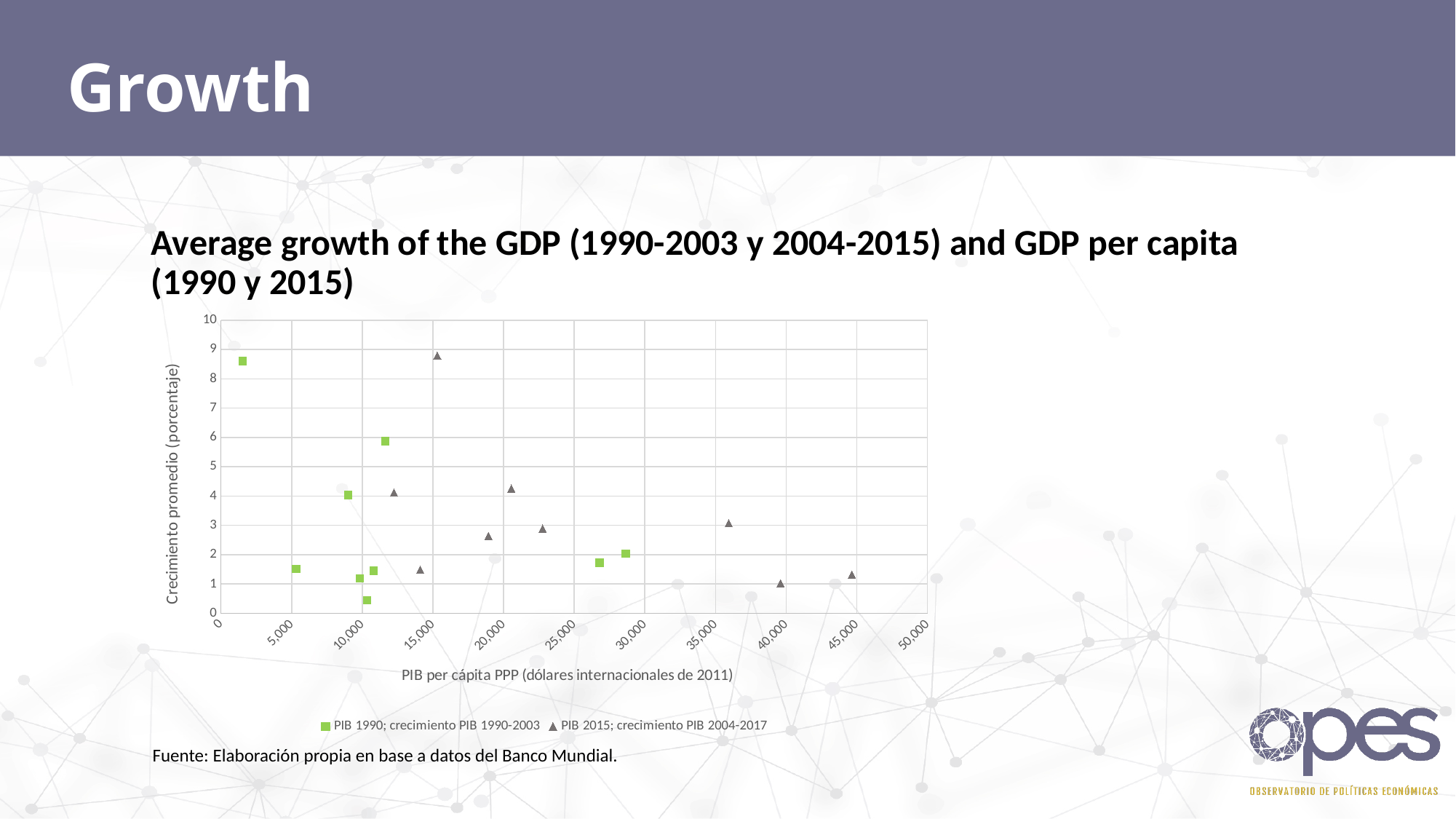
What kind of chart is shown on the slide? Scatter chart Which series contains the point with the highest GDP per capita (furthest right on the x axis)? PIB 2015; crecimiento PIB 2004-2017 Is the lowest growth value among the PIB 2015 series points greater or less than 2? less How many series does the legend list? 2 What is the title of the horizontal axis? PIB per cápita PPP (dólares internacionales de 2011) Which series contains the point with the lowest average growth? PIB 1990; crecimiento PIB 1990-2003 How many green square points (PIB 1990 series) are plotted? 9 Are all the PIB 1990 series points located at a GDP per capita below 30,000? Yes How many grey triangle points (PIB 2015 series) are plotted? 9 Is the rightmost PIB 2015 point's GDP per capita greater or less than 40,000? greater What are the two series named in the legend? PIB 1990; crecimiento PIB 1990-2003 and PIB 2015; crecimiento PIB 2004-2017